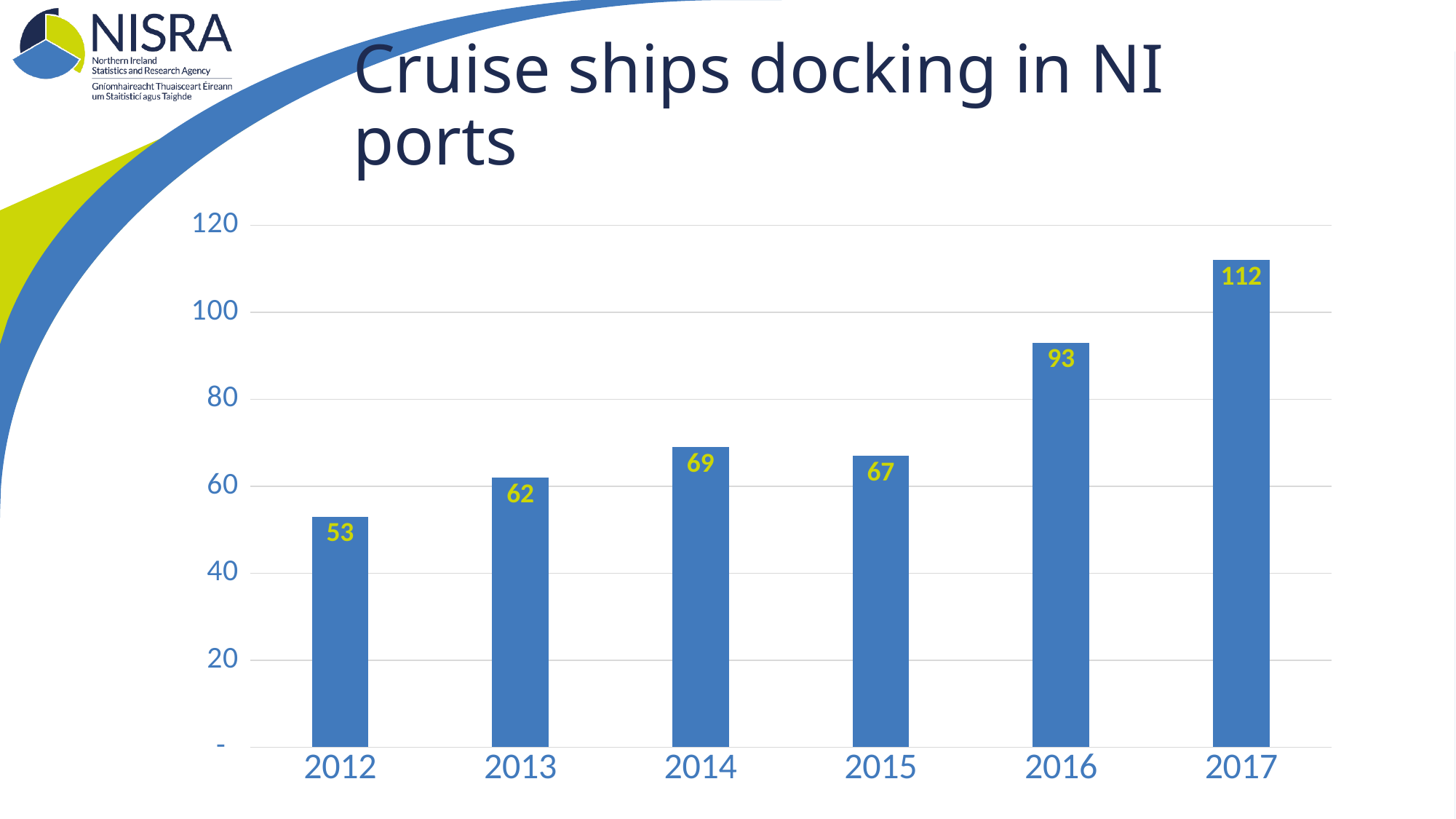
What is the value shown for 2014? 69 How many years are shown on the x axis? 6 What is the title of the slide? Cruise ships docking in NI ports Which year has the highest number of cruise ships docking? 2017 What is the value shown for 2016? 93 Is the value for 2017 greater or less than 100? greater What is the difference between the values for 2017 and 2016? 19 Which year has the larger value, 2014 or 2015? 2014 How many cruise ships docked in NI ports in 2012? 53 Which year has the lowest number of cruise ships docking? 2012 What kind of chart is shown on the slide? Bar chart What is the difference between the values for 2013 and 2012? 9